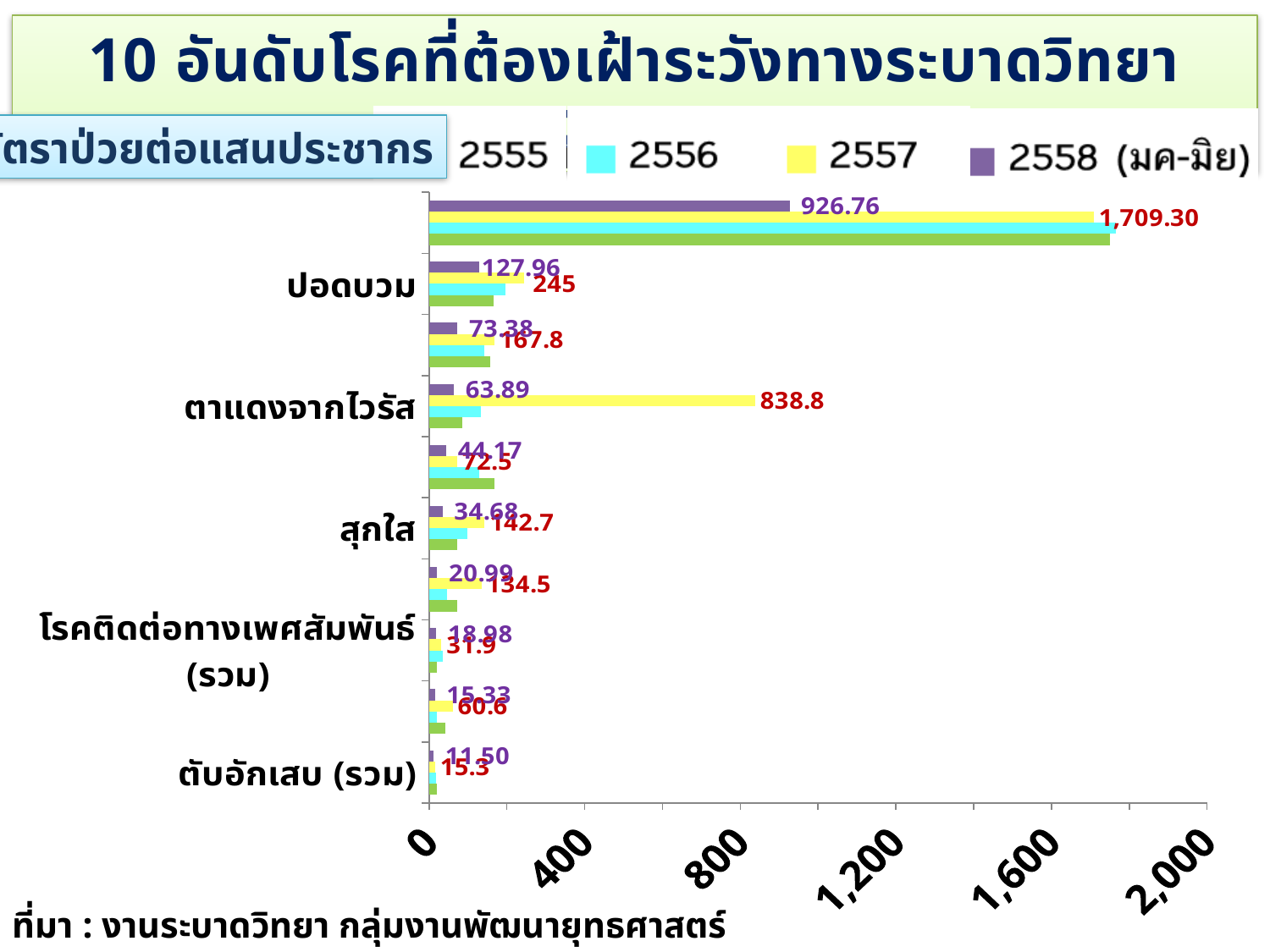
What is the 2557 value for สุกใส? 142.7 What is the 2557 value for โรคติดต่อทางเพศสัมพันธ์ (รวม)? 31.9 How many series does the legend list? 4 What is the 2558 (มค-มิย) value for ตับอักเสบ (รวม)? 11.50 What kind of chart is shown on the slide? bar chart For ตาแดงจากไวรัส, which is larger: the 2557 value or the 2558 (มค-มิย) value? 2557 What is the largest 2557 value labelled on the chart? 1,709.30 Is the 2556 value for ตาแดงจากไวรัส greater or less than 400? less What is the 2557 value for ตาแดงจากไวรัส? 838.8 What is the difference between the 2557 and 2558 (มค-มิย) values for ปอดบวม? 117.04 What is the 2558 (มค-มิย) value for ปอดบวม? 127.96 How many disease categories are plotted in the chart? 10